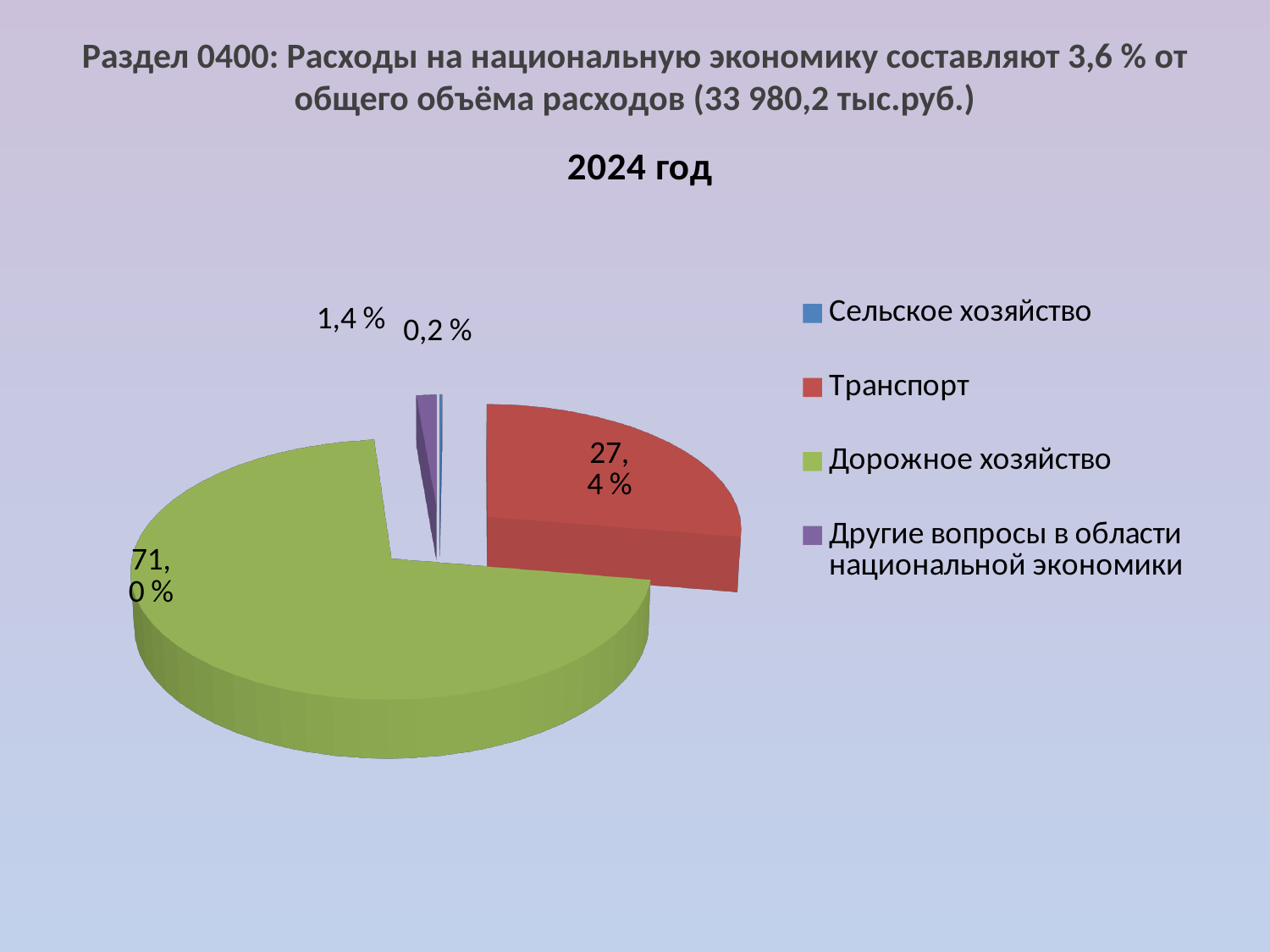
How many categories are shown in the pie chart? 4 What colour is the slice for Транспорт? Red What kind of chart is shown on the slide? Pie chart What share of the pie does Другие вопросы в области национальной экономики have? 1,4 % Which is larger, the slice for Транспорт or the slice for Другие вопросы в области национальной экономики? Транспорт What is the difference in percentage points between Дорожное хозяйство and Транспорт? 43,6 Which category has the smallest slice of the pie? Сельское хозяйство What share of the pie does Сельское хозяйство have? 0,2 % What share of the pie does Дорожное хозяйство have? 71,0 % What share of the pie does Транспорт have? 27,4 % Which category has the largest slice of the pie? Дорожное хозяйство What is the title of the chart? 2024 год